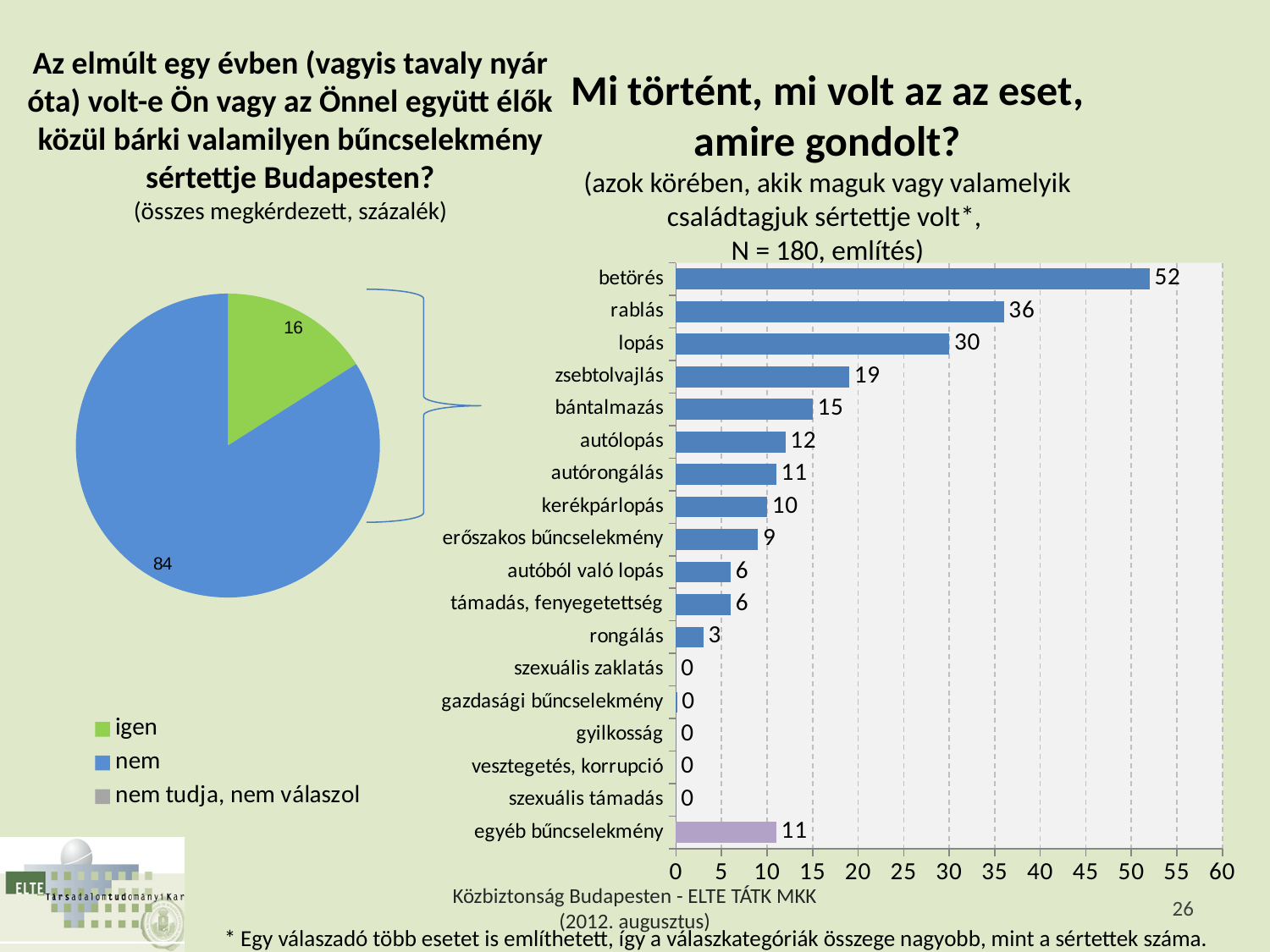
What kind of chart is the chart on the right of the slide? bar chart How many categories are shown in the bar chart on the right? 18 In the bar chart on the right, what is the value for 'rablás'? 36 What kind of chart is the chart on the left of the slide? pie chart In the bar chart on the right, what is the difference between the values for 'betörés' and 'rablás'? 16 In the pie chart on the left, what value is shown for the 'igen' slice? 16 In the bar chart on the right, which is larger: the value for 'lopás' or the value for 'zsebtolvajlás'? lopás In the bar chart on the right, what is the value for 'egyéb bűncselekmény'? 11 In the bar chart on the right, which category has the highest value? betörés In the bar chart on the right, what is the value for 'kerékpárlopás'? 10 In the pie chart on the left, what value is shown for the 'nem' slice? 84 How many entries does the legend of the pie chart on the left list? 3